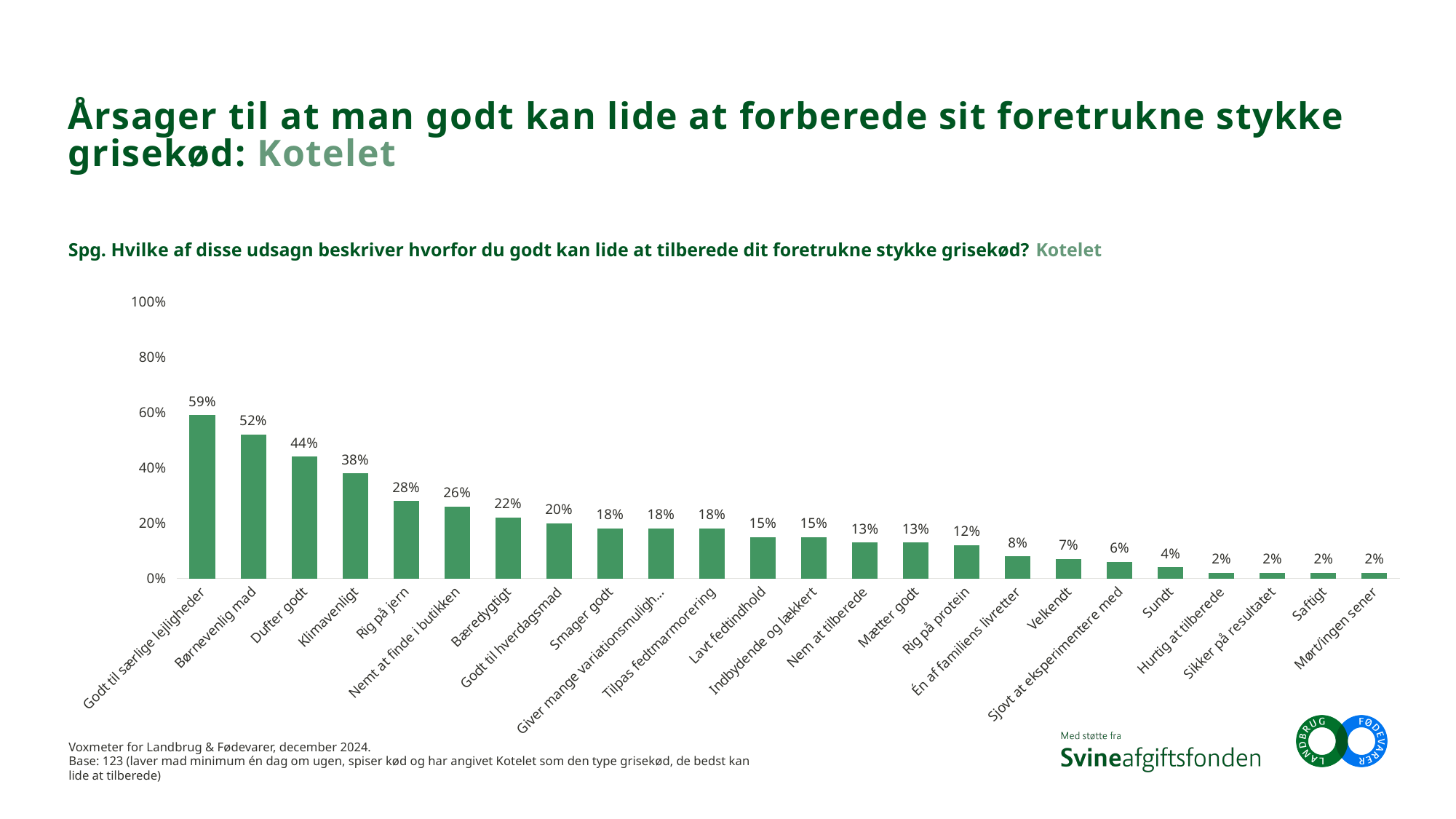
What is the difference between "Rig på jern" and "Bæredygtigt"? 6% What kind of chart is shown on the slide? Bar chart How many categories are shown in the chart? 24 Which is larger, "Velkendt" or "Én af familiens livretter"? Én af familiens livretter What is the value for "Sundt"? 4% Which is larger, "Nemt at finde i butikken" or "Godt til hverdagsmad"? Nemt at finde i butikken What is the difference between "Godt til særlige lejligheder" and "Dufter godt"? 15% Do the values rise or fall from left to right along the x axis? Fall Which category has the highest value? Godt til særlige lejligheder What percentage is shown for "Børnevenlig mad"? 52% What percentage is shown for "Rig på protein"? 12% What is the value for "Klimavenligt"? 38%